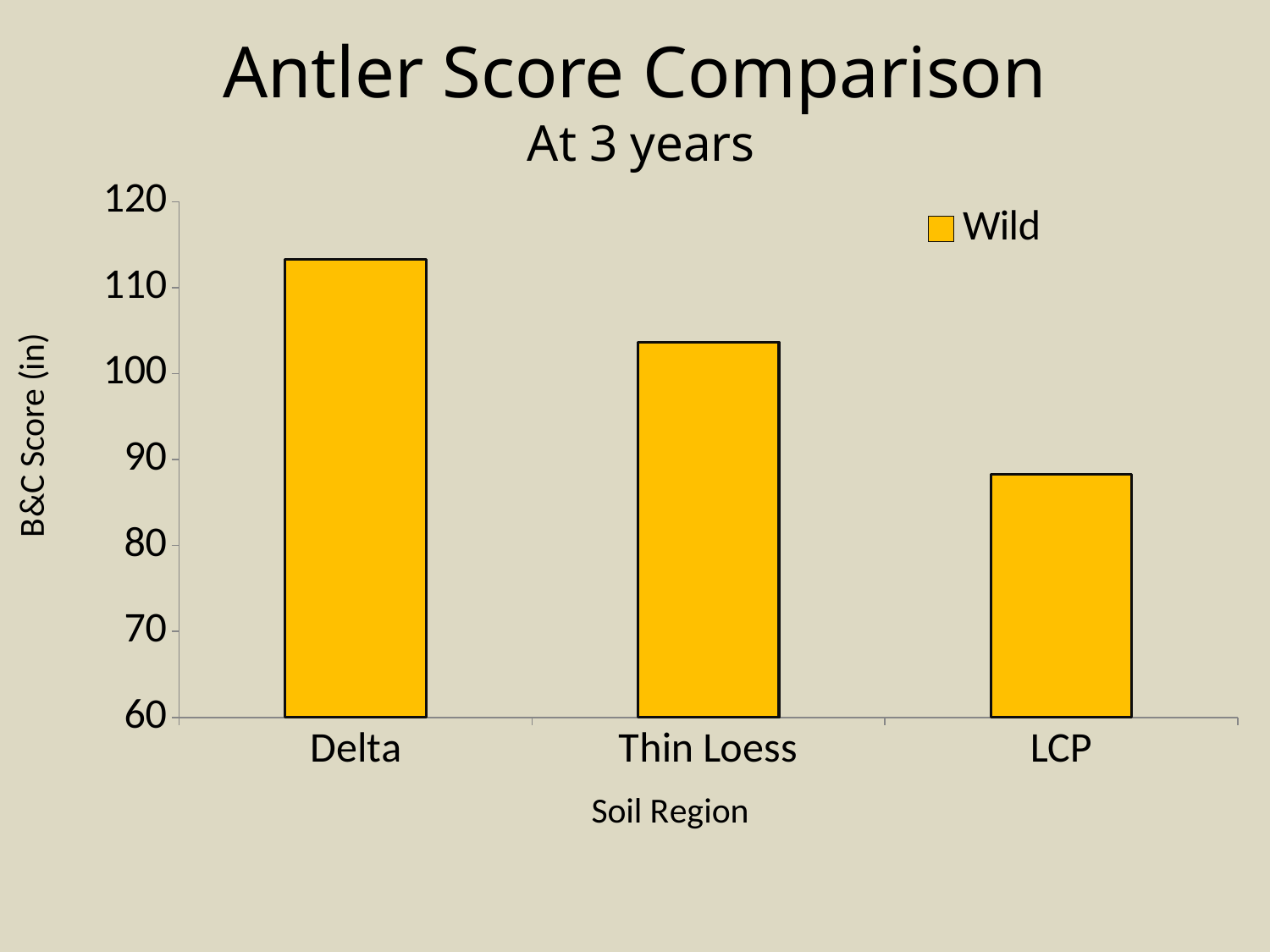
What is the label of the y axis? B&C Score (in) Is the B&C score for LCP greater or less than 90? less How many series does the legend list? 1 What kind of chart is shown on the slide? bar chart Do the B&C scores rise or fall from Delta to LCP along the x axis? fall Which soil region has the lowest B&C score? LCP How many soil regions are shown on the x axis? 3 Is the B&C score for Delta greater or less than 110? greater Which soil region has the highest B&C score? Delta Which has a higher B&C score, Delta or Thin Loess? Delta Which has a higher B&C score, Thin Loess or LCP? Thin Loess Is the B&C score for Thin Loess greater or less than 100? greater